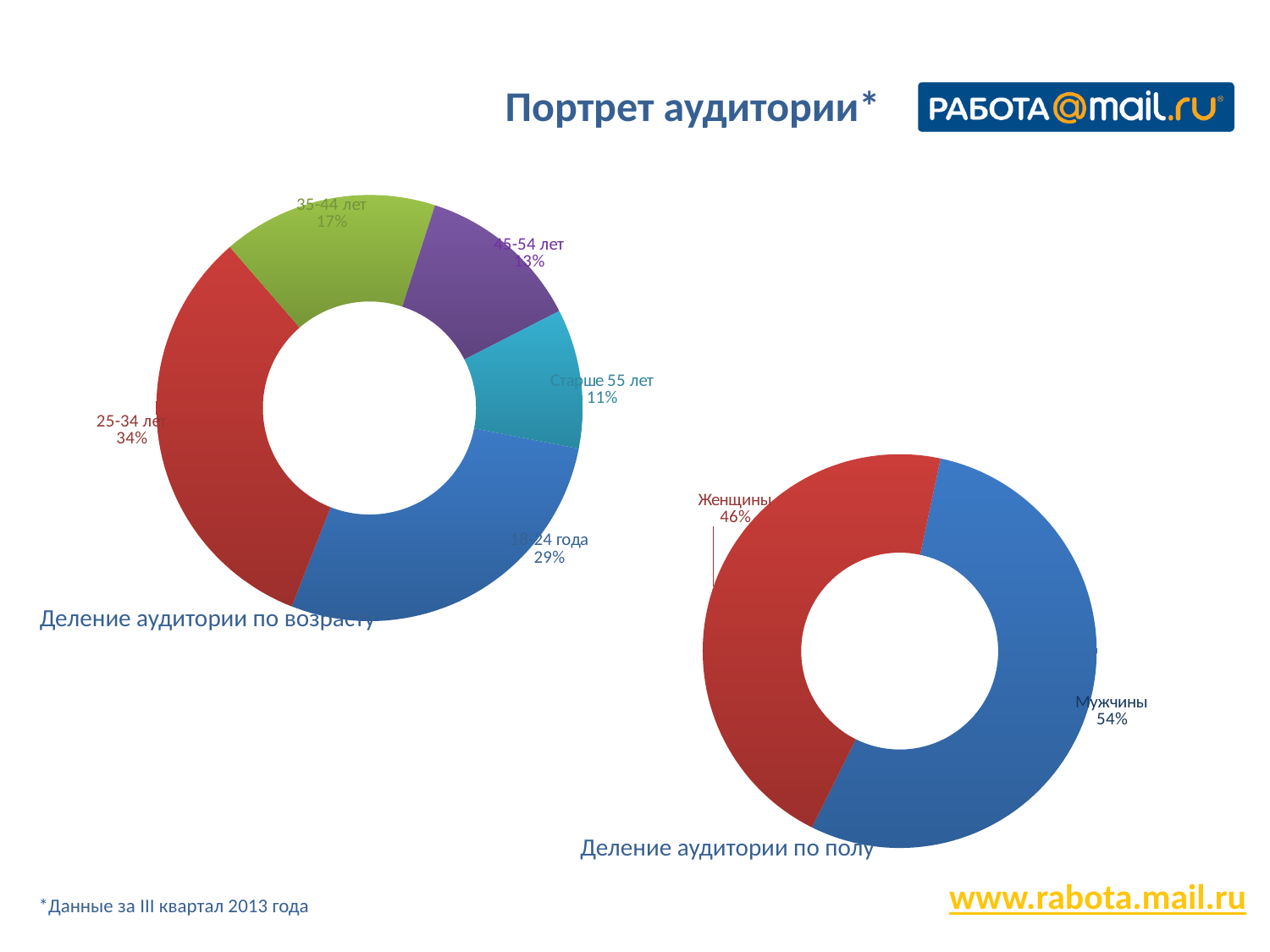
In the "Деление аудитории по возрасту" chart, what share of the audience is aged 25-34 лет? 34% In the "Деление аудитории по полу" chart, what share of the audience is Женщины? 46% In the "Деление аудитории по возрасту" chart, what share of the audience is aged 18-24 года? 29% In the "Деление аудитории по возрасту" chart, what is the difference in percentage points between the 25-34 лет and 18-24 года groups? 5 percentage points In the "Деление аудитории по полу" chart, which group is larger, Мужчины or Женщины? Мужчины How many age groups are shown in the "Деление аудитории по возрасту" chart? 5 In the "Деление аудитории по полу" chart, by how many percentage points does Мужчины exceed Женщины? 8 percentage points In the "Деление аудитории по возрасту" chart, what share of the audience is Старше 55 лет? 11% In the "Деление аудитории по возрасту" chart, what share of the audience is aged 35-44 лет? 17% What kind of chart is the "Деление аудитории по возрасту" chart? doughnut chart In the "Деление аудитории по возрасту" chart, which age group has the largest share? 25-34 лет In the "Деление аудитории по полу" chart, what share of the audience is Мужчины? 54%